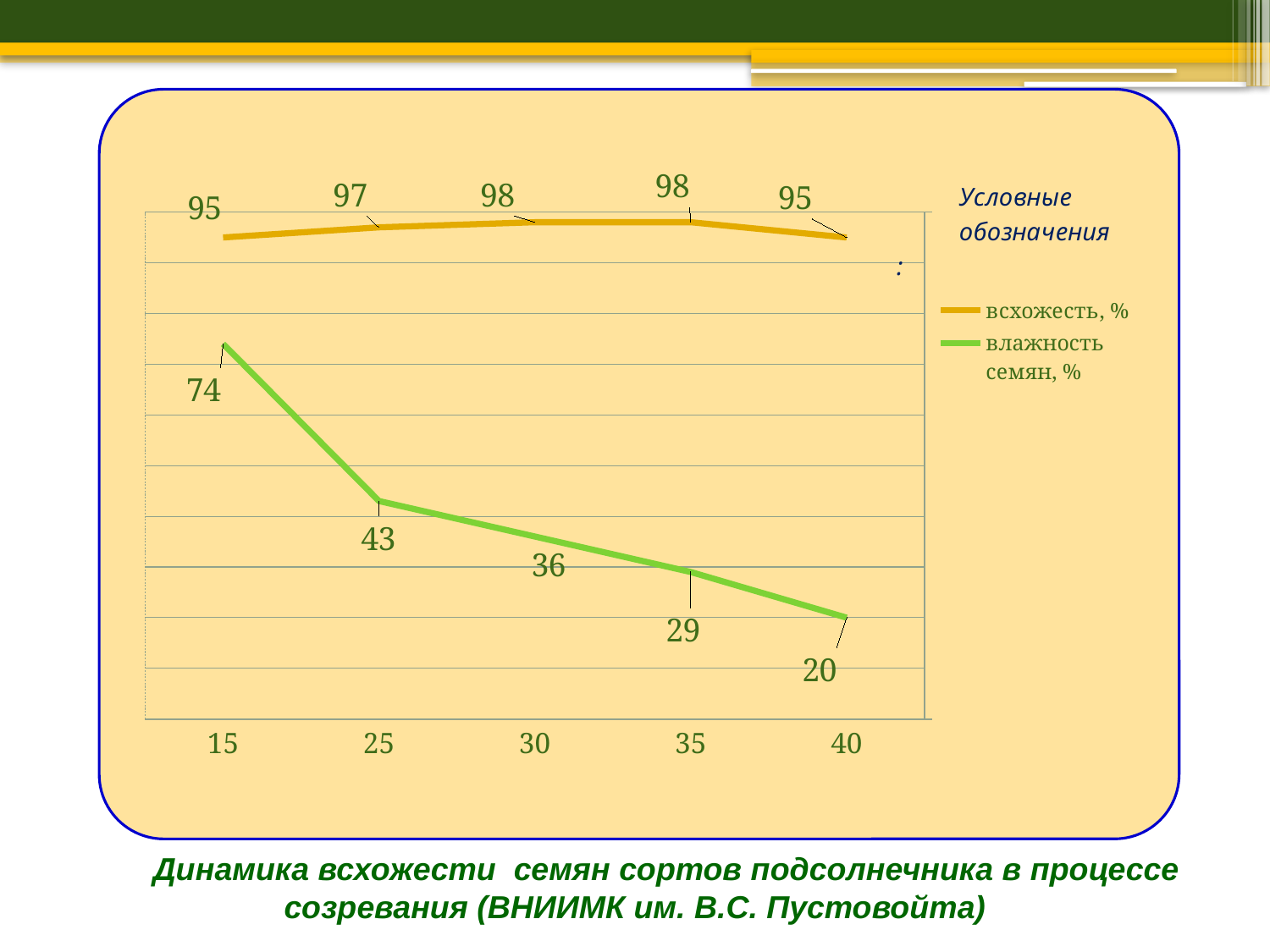
Does влажность семян, % rise or fall as x increases from 15 to 40? fall How many data points does the влажность семян, % series have? 5 What is the value of влажность семян, % at x = 40? 20 At which x value is влажность семян, % highest? 15 How many series does the legend list? 2 What is the value of влажность семян, % at x = 25? 43 Which is larger at x = 35: всхожесть, % or влажность семян, %? всхожесть, % What is the difference between влажность семян, % at x = 15 and at x = 25? 31 What is the difference between всхожесть, % and влажность семян, % at x = 40? 75 What is the value of всхожесть, % at x = 15? 95 What is the value of всхожесть, % at x = 30? 98 At which x value is влажность семян, % lowest? 40